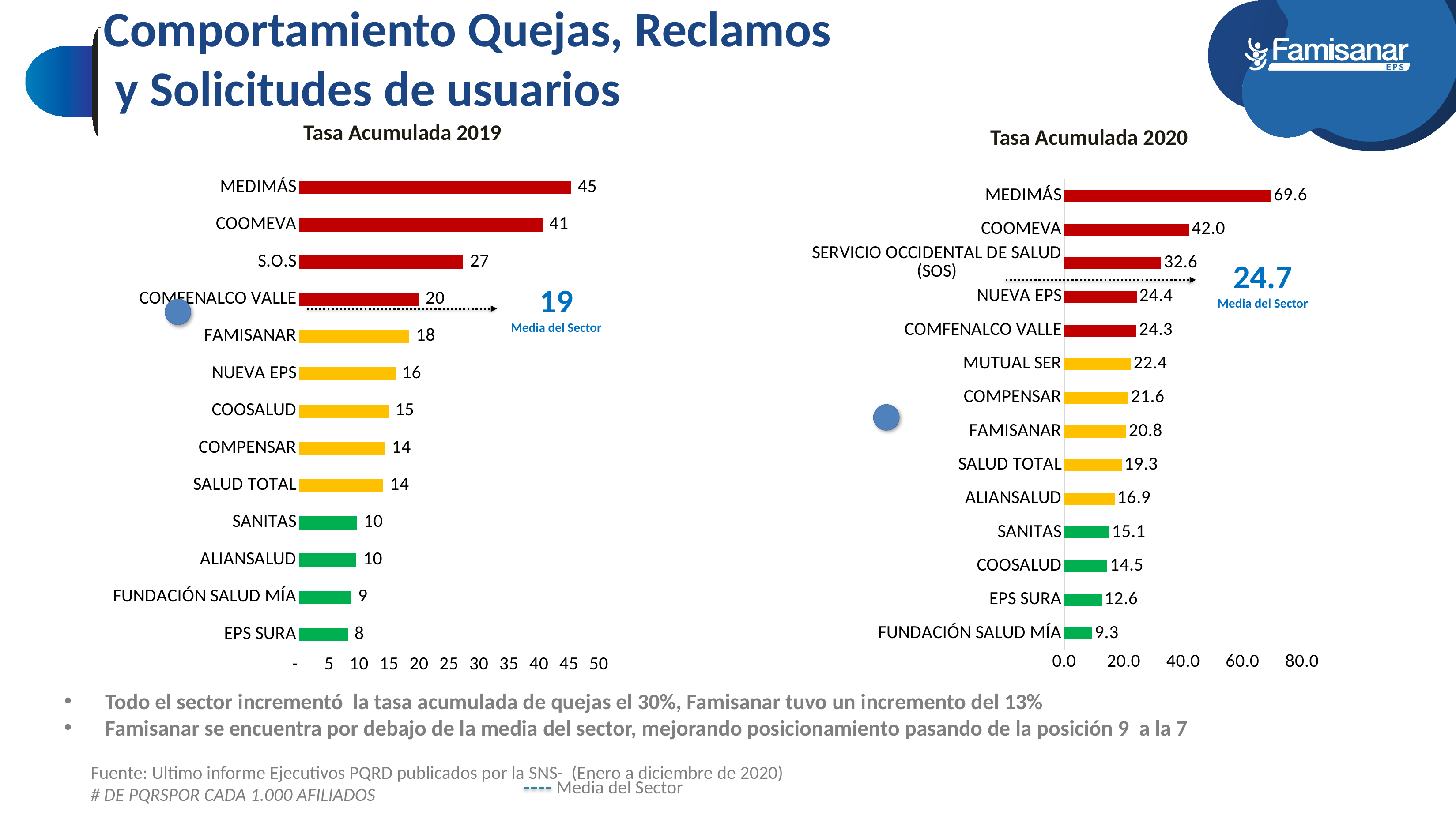
In the 'Tasa Acumulada 2019' chart, which category has the lowest value? EPS SURA In the 'Tasa Acumulada 2020' chart, what is the difference between MEDIMÁS and COOMEVA? 27.6 In the 'Tasa Acumulada 2019' chart, what is the difference between COOMEVA and S.O.S? 14 In the 'Tasa Acumulada 2020' chart, what is the value for FAMISANAR? 20.8 How many categories are shown in the 'Tasa Acumulada 2019' chart? 13 How many categories are shown in the 'Tasa Acumulada 2020' chart? 14 What kind of chart is the 'Tasa Acumulada 2020' chart? Bar chart In the 'Tasa Acumulada 2019' chart, what is the value for FAMISANAR? 18 In the 'Tasa Acumulada 2020' chart, what is the value shown for 'Media del Sector'? 24.7 In the 'Tasa Acumulada 2020' chart, which category has the lowest value? FUNDACIÓN SALUD MÍA In the 'Tasa Acumulada 2020' chart, which is larger, the value for MUTUAL SER or the value for SALUD TOTAL? MUTUAL SER In the 'Tasa Acumulada 2019' chart, which category has the highest value? MEDIMÁS